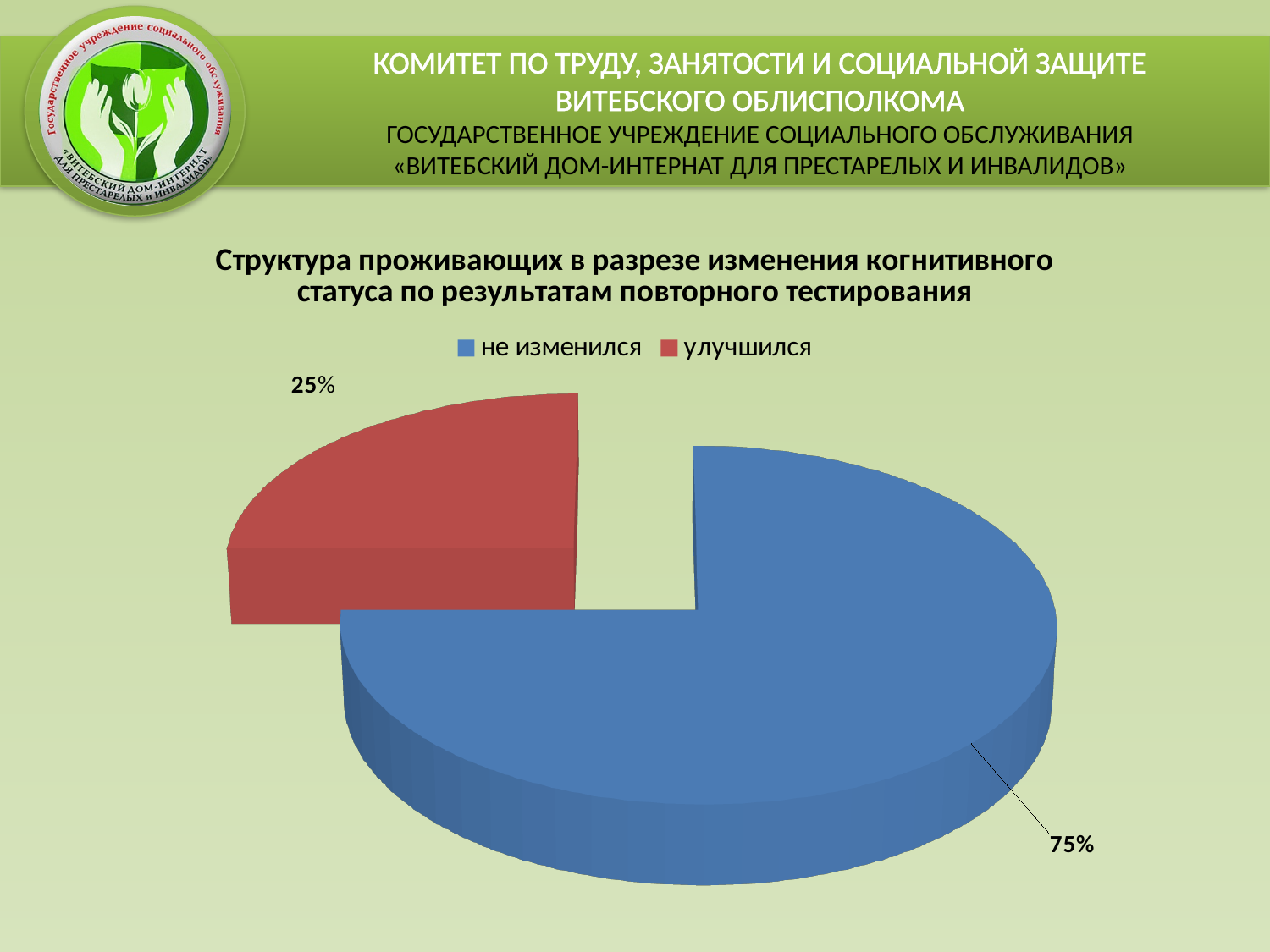
Which is larger: the "не изменился" slice or the "улучшился" slice? не изменился What is the difference in percentage points between the "не изменился" and "улучшился" slices? 50 What kind of chart is shown on the slide? pie chart How many entries does the legend list? 2 What share of the pie does the "не изменился" slice represent? 75% What share of the pie does the "улучшился" slice represent? 25% Which category has the smallest slice of the pie? улучшился What colour is the "улучшился" slice? red Which category has the largest slice of the pie? не изменился How many slices does the pie chart have? 2 What colour is the "не изменился" slice? blue